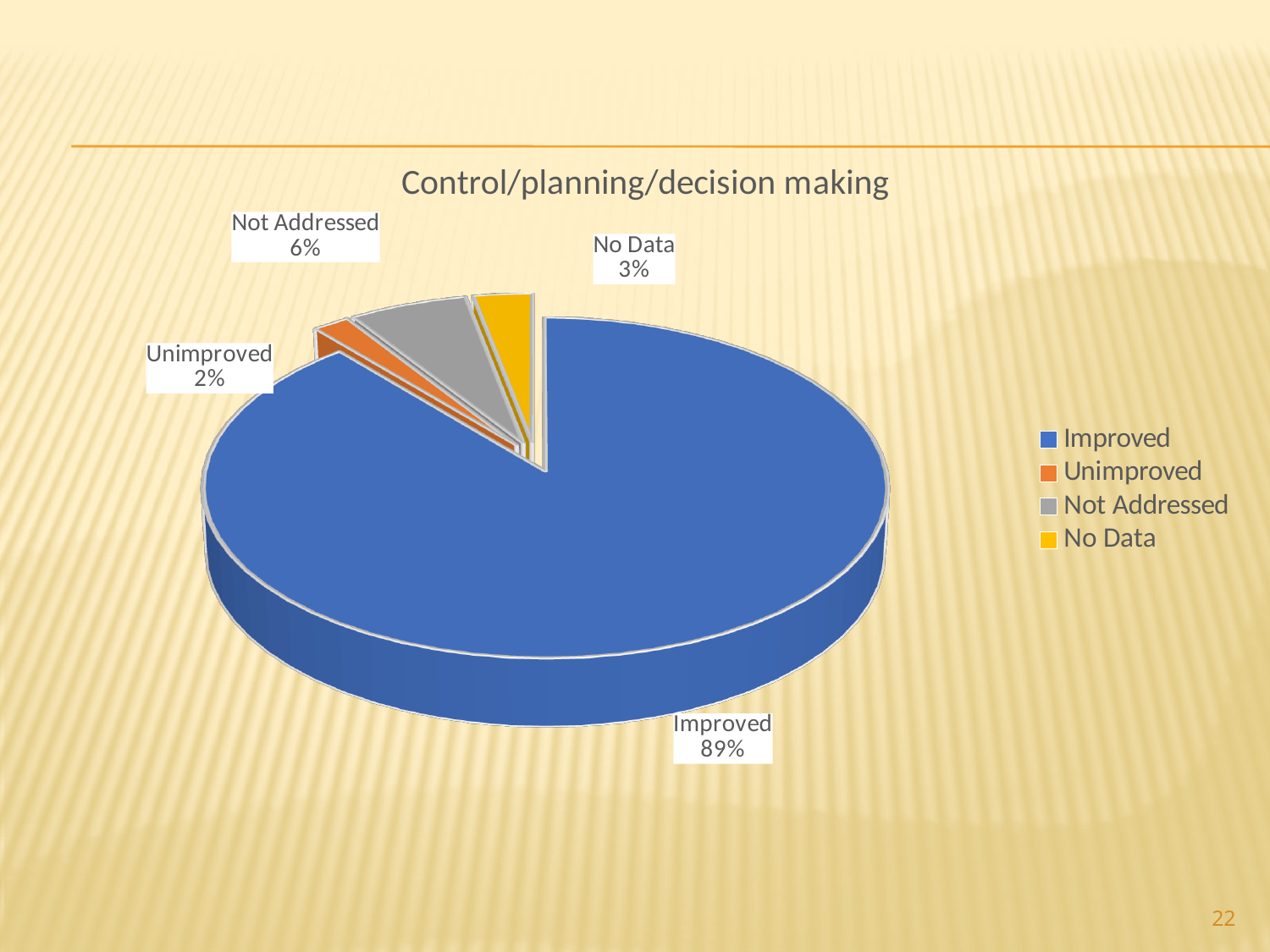
What is the value shown for Not Addressed? 6% How many categories are shown in the pie chart? 4 What is the value shown for No Data? 3% What is the value shown for Unimproved? 2% What is the title of the chart? Control/planning/decision making What is the difference between the Not Addressed and No Data shares? 3% What type of chart is shown on the slide? Pie chart Which category has the smallest slice of the pie? Unimproved What share of the pie does Improved represent? 89% Which category has the largest slice of the pie? Improved Which is larger, the share for Not Addressed or the share for No Data? Not Addressed What is the difference between the Improved and Not Addressed shares? 83%